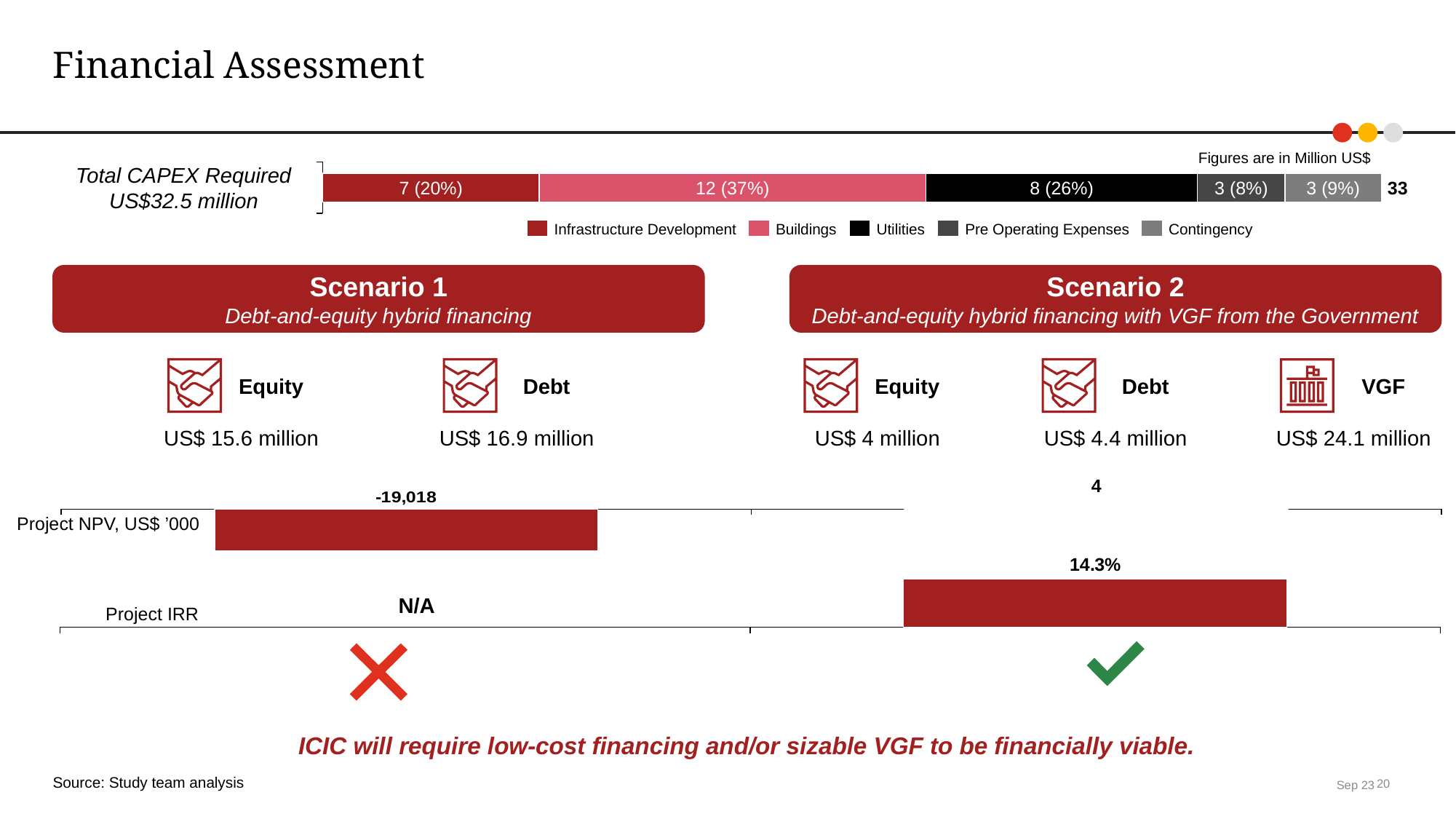
In the Total CAPEX Required stacked bar chart, what is the value for Utilities? 8 (26%) In the Total CAPEX Required stacked bar chart, what is the value for Infrastructure Development? 7 (20%) In the Total CAPEX Required stacked bar chart, what is the value for Buildings? 12 (37%) In the Total CAPEX Required stacked bar chart, what is the total shown at the end of the bar? 33 In the Project NPV chart, what is the value for Scenario 1? -19,018 In the Total CAPEX Required stacked bar chart, what is the difference between the Buildings value and the Utilities value? 4 In the Total CAPEX Required stacked bar chart, which is larger, Infrastructure Development or Utilities? Utilities In the Total CAPEX Required stacked bar chart, what share of the total does Contingency represent? 9% In the Total CAPEX Required stacked bar chart, which category has the largest value? Buildings What kind of chart is used to show the Total CAPEX Required breakdown? Stacked bar chart In the Project IRR chart, what is the value for Scenario 2? 14.3% In the Total CAPEX Required stacked bar chart, how many categories does the legend list? 5